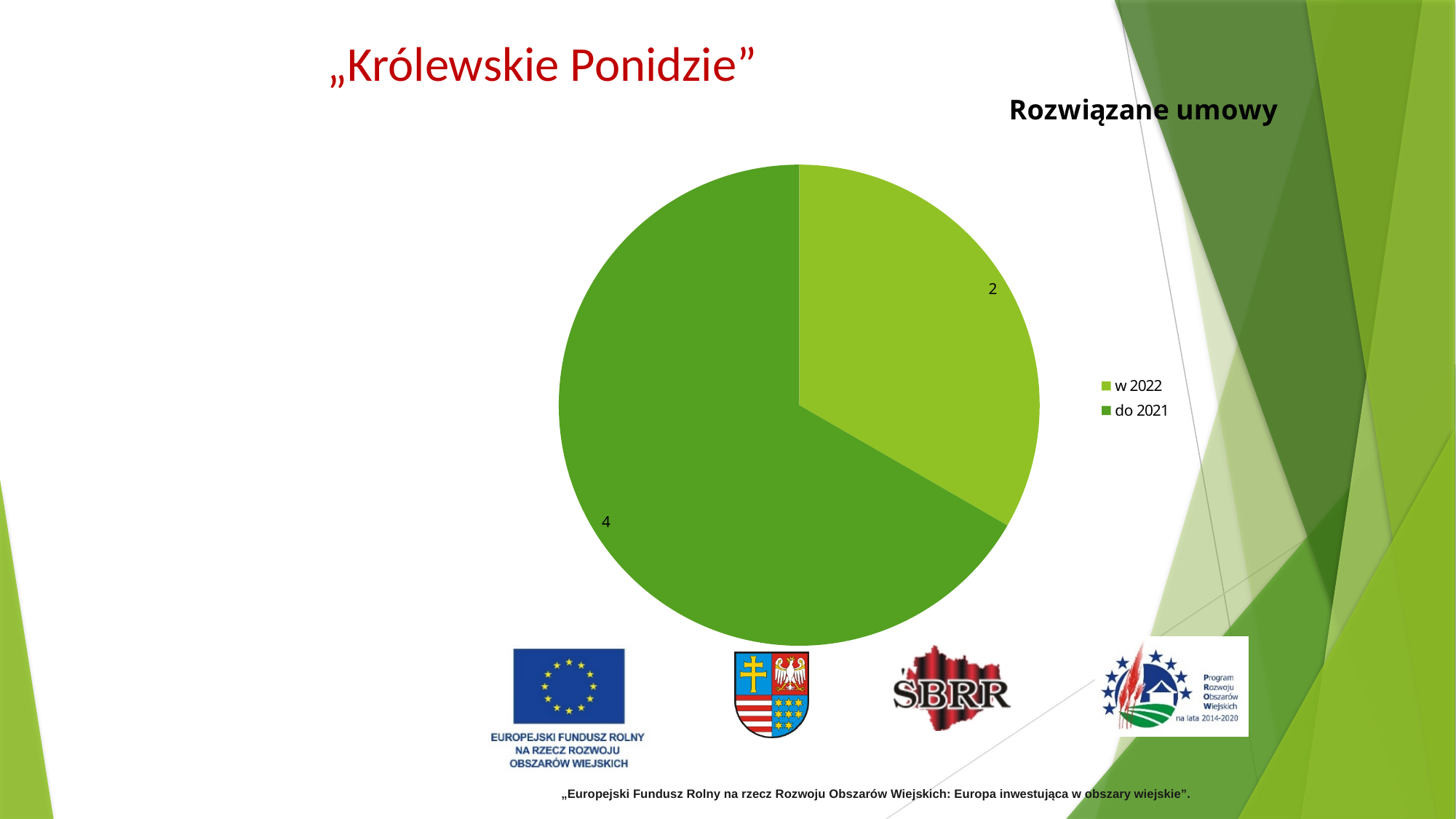
What kind of chart is shown on the slide? pie chart How many entries does the legend list? 2 What share of the pie does the "w 2022" slice represent? 1/3 What is the total of all slices in the pie chart? 6 Which category has the largest slice in the pie chart? do 2021 Which is larger, the value for "w 2022" or the value for "do 2021"? do 2021 How many slices does the pie chart have? 2 What is the value for "do 2021" in the pie chart? 4 What is the title of the chart? Rozwiązane umowy Which category has the smallest slice in the pie chart? w 2022 What is the difference between the values for "do 2021" and "w 2022"? 2 What is the value for "w 2022" in the pie chart? 2